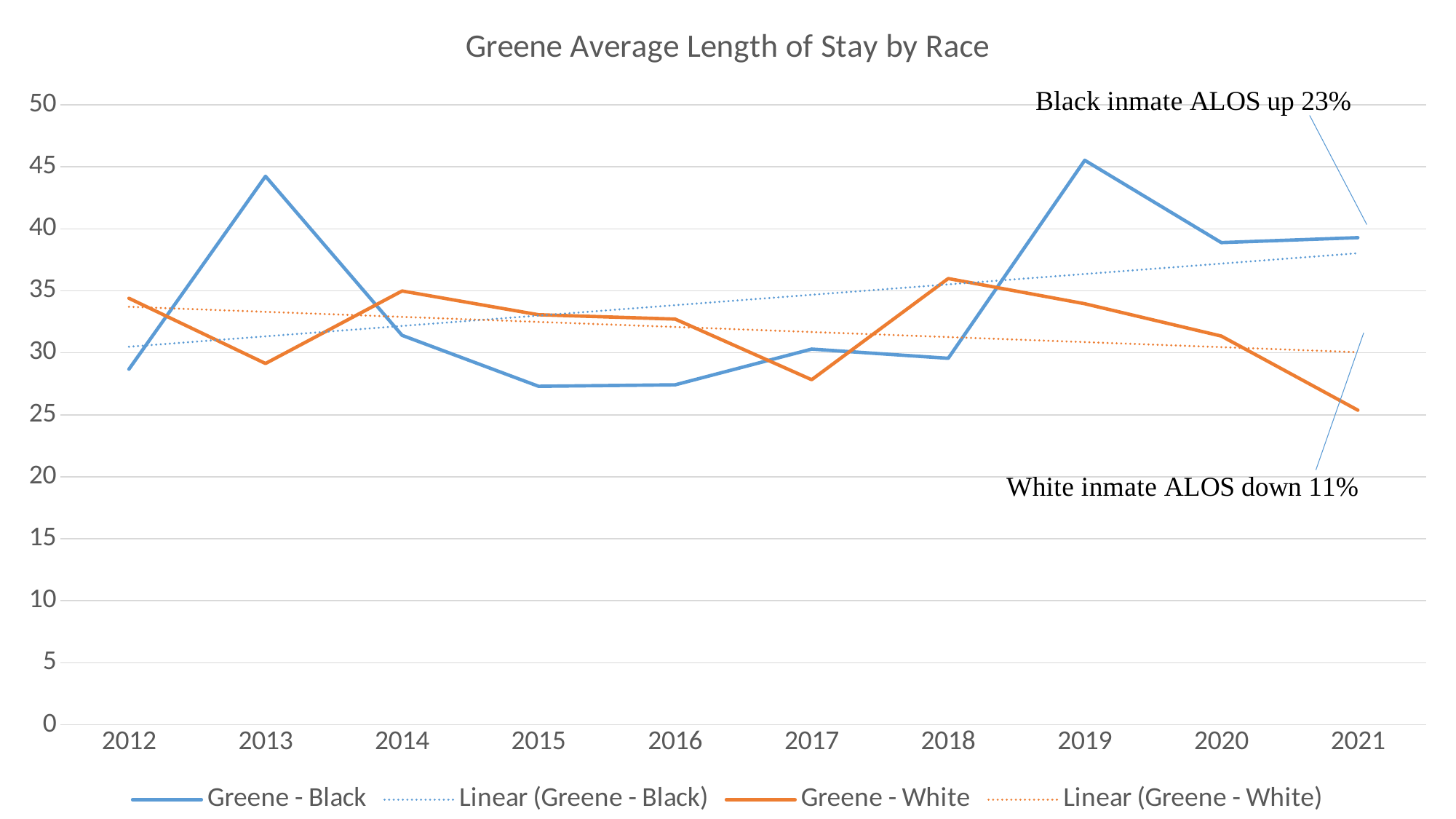
Does the Linear (Greene - White) trend line rise or fall from 2012 to 2021? fall How many years are shown on the x axis? 10 What is the title of the chart? Greene Average Length of Stay by Race In which year does the Greene - White series reach its lowest value? 2021 In 2014, which series has the larger value, Greene - Black or Greene - White? Greene - White Is the value for Greene - White in 2021 greater or less than 30? less Is the value for Greene - Black in 2013 greater or less than 40? greater In 2021, which series has the larger value, Greene - Black or Greene - White? Greene - Black How many series does the legend list? 4 What kind of chart is shown on the slide? line chart In which year does the Greene - Black series reach its highest value? 2019 Is the value for Greene - Black in 2015 greater or less than 30? less